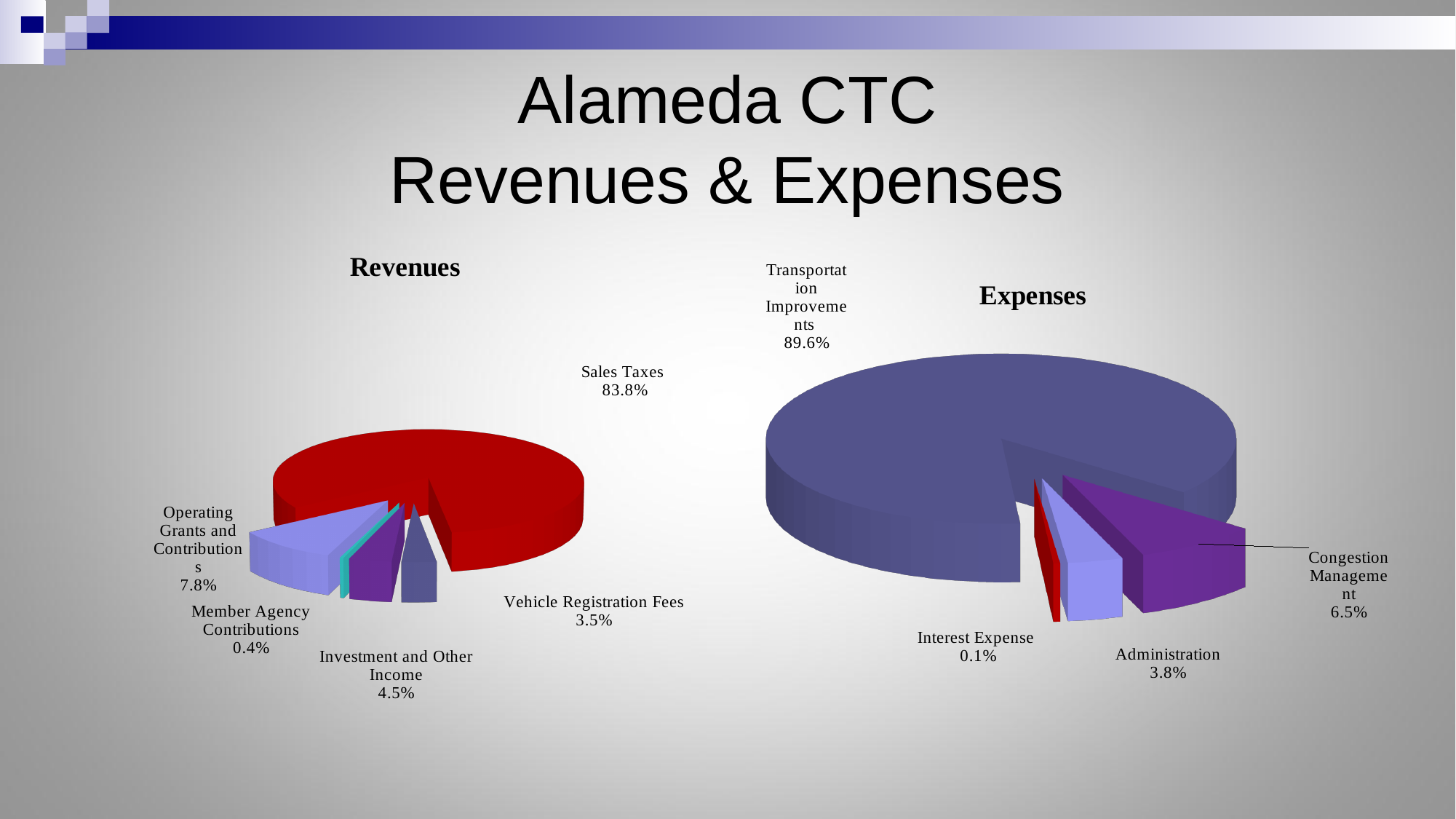
In the Expenses chart, what share of expenses is Transportation Improvements? 89.6% In the Revenues chart, what is the difference between Operating Grants and Contributions and Vehicle Registration Fees? 4.3% In the Expenses chart, which category has the smallest share? Interest Expense In the Expenses chart, which is larger, Administration or Congestion Management? Congestion Management In the Revenues chart, what share of revenues comes from Sales Taxes? 83.8% In the Expenses chart, what percentage is shown for Congestion Management? 6.5% In the Revenues chart, which category has the largest share? Sales Taxes In the Revenues chart, what percentage is shown for Operating Grants and Contributions? 7.8% In the Revenues chart, which category has the smallest share? Member Agency Contributions In the Revenues chart, how many categories are shown? 5 In the Revenues chart, what percentage is shown for Investment and Other Income? 4.5% What type of chart is the Expenses chart? Pie chart